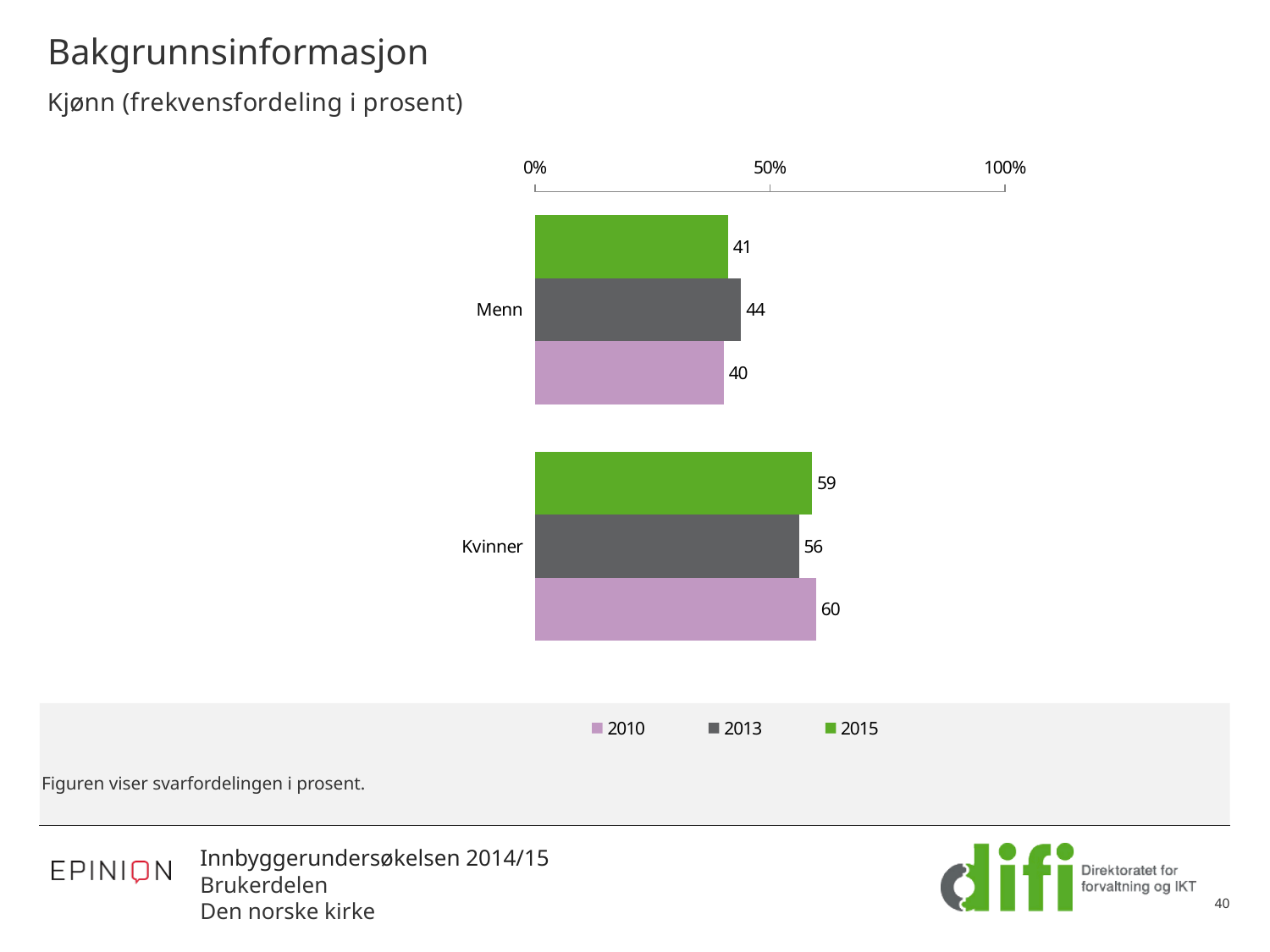
How many series does the legend list? 3 Which category has the lowest value in 2010? Menn What kind of chart is shown on the slide? Bar chart What is the value for Menn in 2015? 41 What is the value for Kvinner in 2010? 60 Is the value for Kvinner in 2010 greater or less than 50%? greater What is the value for Kvinner in 2013? 56 Which is larger, the Menn value in 2013 or the Menn value in 2010? Menn in 2013 What is the difference between the Kvinner and Menn values in 2015? 18 Which category has the highest value in 2015? Kvinner What is the value for Menn in 2013? 44 How many categories are shown on the chart? 2